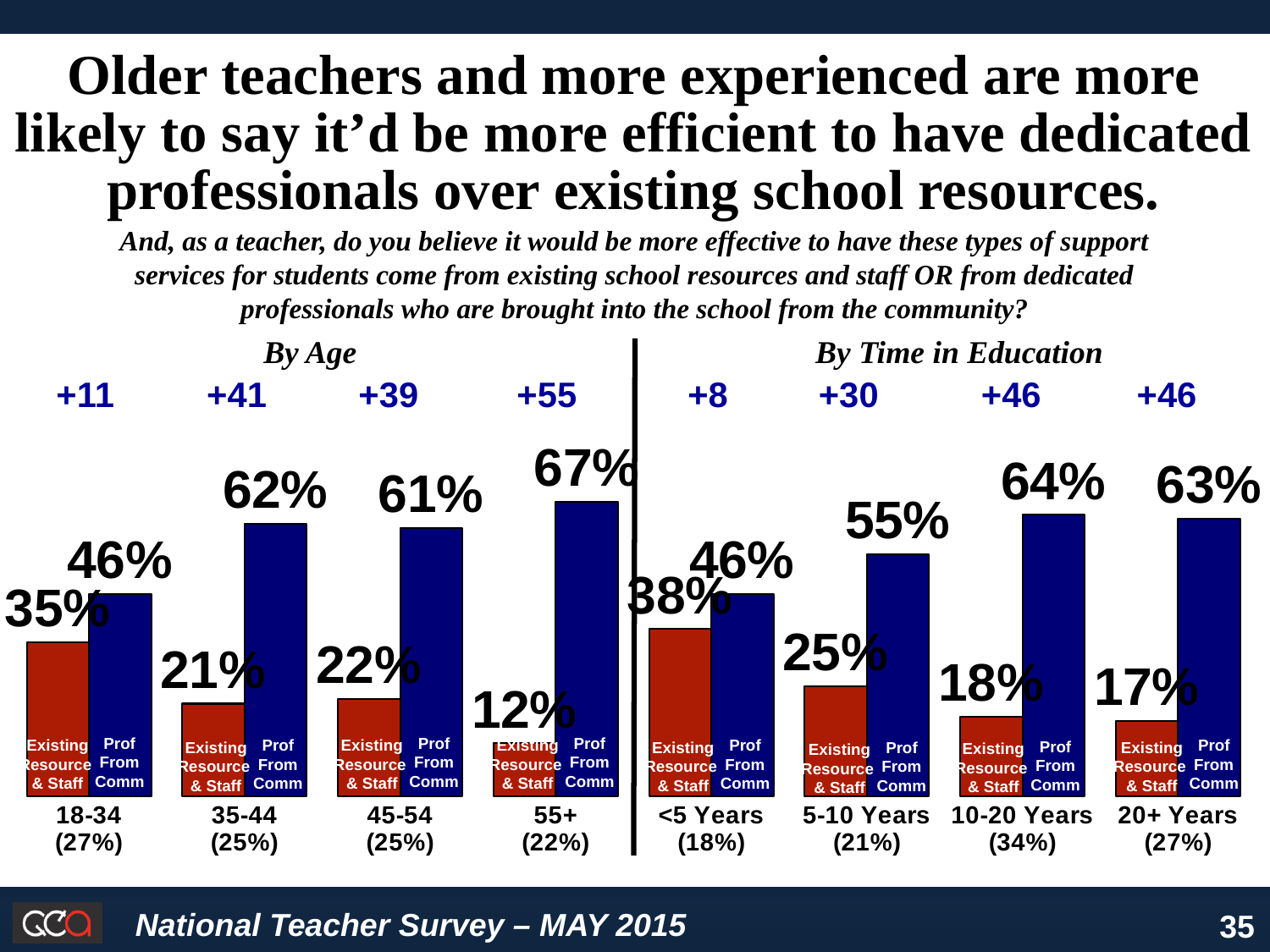
In the By Age chart, what percentage of teachers aged 18-34 chose Existing Resource & Staff? 35% In the By Age chart, what is the difference between the Prof From Comm and Existing Resource & Staff values for the 35-44 group? 41 percentage points In the By Time in Education chart, which group has the highest Existing Resource & Staff value? <5 Years In the By Age chart, what percentage of teachers aged 55+ chose Prof From Comm? 67% In the By Time in Education chart, what percentage of teachers with 5-10 Years chose Prof From Comm? 55% In the By Time in Education chart, what percentage of teachers with 20+ Years chose Existing Resource & Staff? 17% In the By Time in Education chart, which is larger for the 10-20 Years group: Existing Resource & Staff or Prof From Comm? Prof From Comm In the By Age chart, which age group has the highest Prof From Comm value? 55+ In the By Time in Education chart, what is the net difference shown above the <5 Years group? +8 What type of chart is used on this slide? Bar chart In the By Age chart, which age group has the lowest Existing Resource & Staff value? 55+ How many age groups are shown in the By Age chart? 4